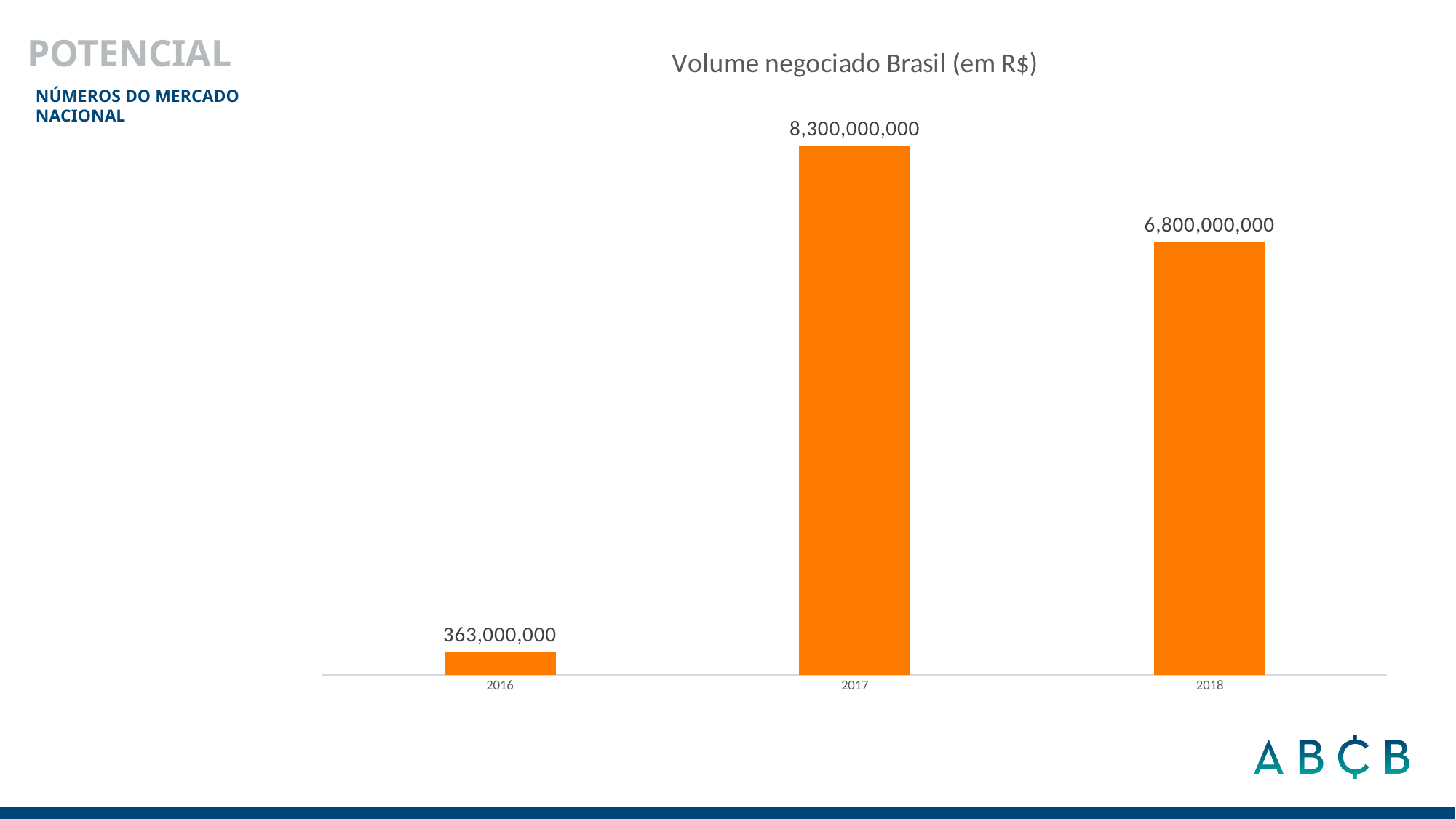
How many years are shown on the chart? 3 What is the value for 2018? 6,800,000,000 Which year has the lowest value? 2016 Does the value rise or fall from 2017 to 2018? fall What is the difference between the values for 2017 and 2018? 1,500,000,000 What is the value for 2017? 8,300,000,000 What is the difference between the values for 2017 and 2016? 7,937,000,000 Which is larger, the value for 2018 or the value for 2016? 2018 What is the value for 2016? 363,000,000 What kind of chart is shown? bar chart What is the title of the chart? Volume negociado Brasil (em R$) Which year has the highest value? 2017